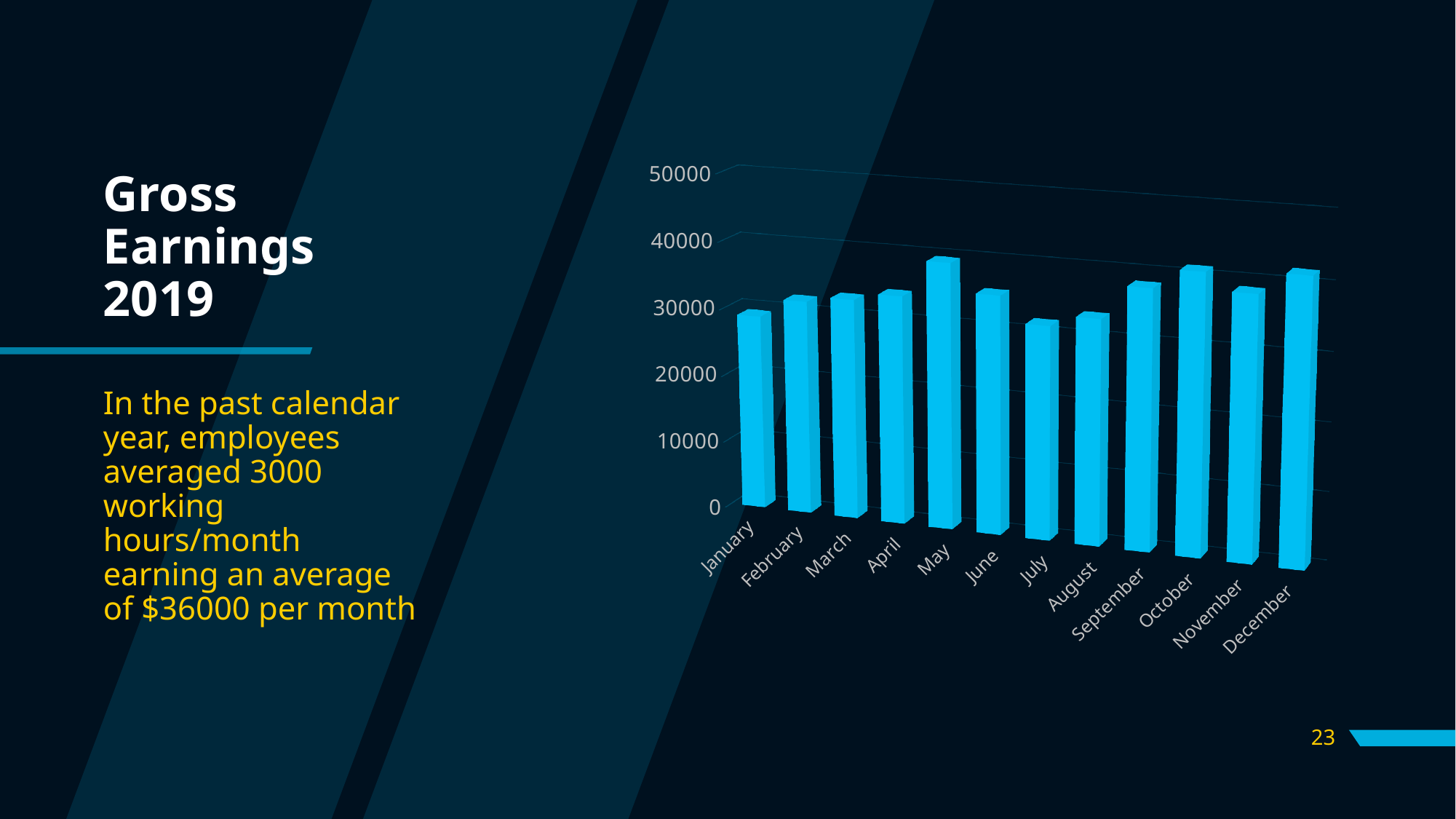
Which is larger, the value for January or the value for October? October How many months are plotted on the chart? 12 Is the value for December greater or less than 50000? less Is the value for July greater or less than 40000? less Which is larger, the value for August or the value for September? September Is the value for October greater or less than 20000? greater What kind of chart is shown on the slide? bar chart Which is larger, the value for May or the value for July? May What colour are the bars in the chart? blue What is the title of the slide containing the chart? Gross Earnings 2019